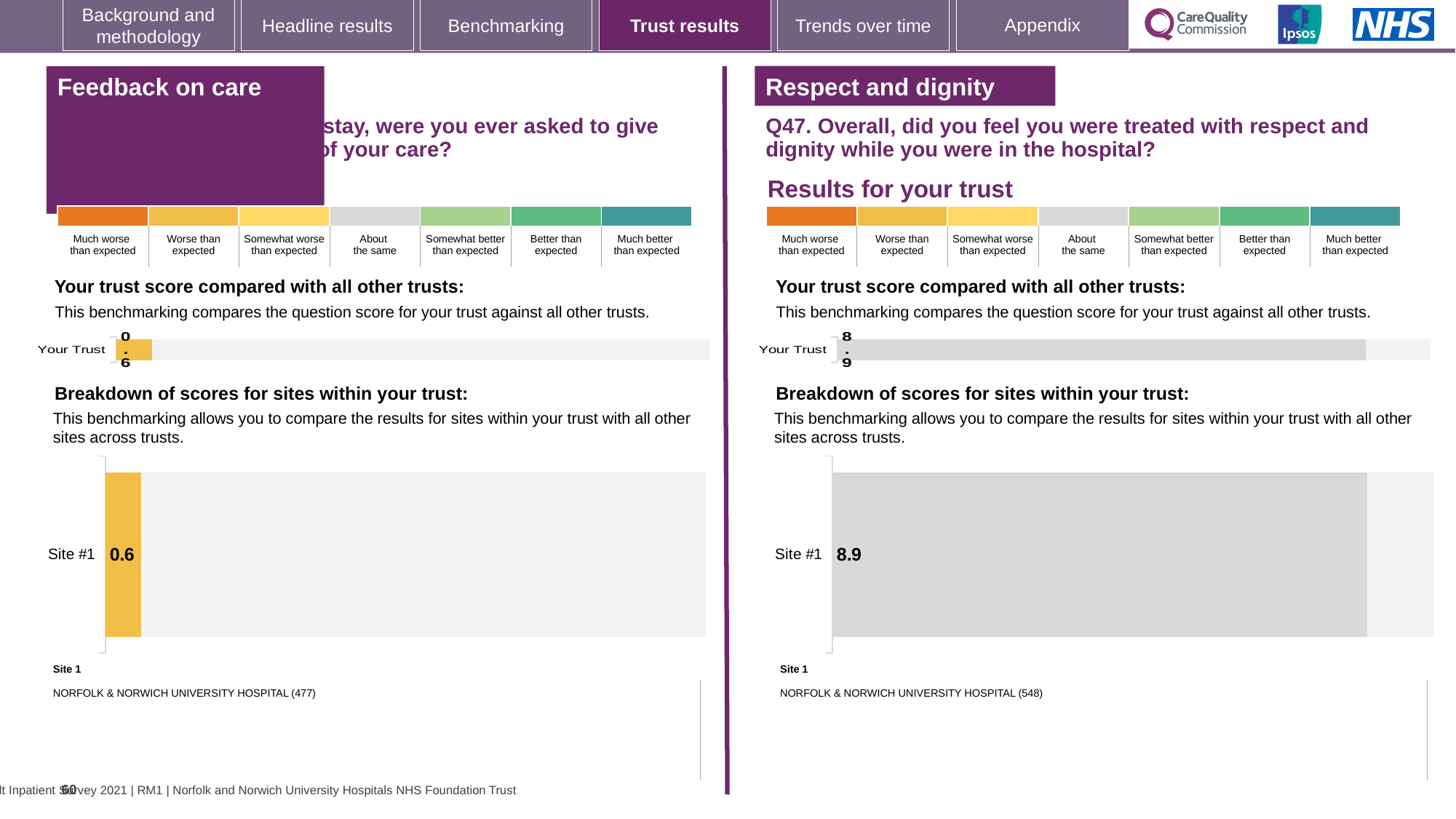
What kind of chart is used for the site breakdown in the Feedback on care section? Bar chart What colour is the Site #1 bar in the Respect and dignity site breakdown chart? Grey Which site breakdown chart shows the higher Site #1 score, Feedback on care or Respect and dignity? Respect and dignity How many sites are shown in the Respect and dignity site breakdown chart? 1 In the Feedback on care site breakdown chart, what is the score for Site #1? 0.6 In the Respect and dignity 'Your trust score compared with all other trusts' chart, what is the value for Your Trust? 8.9 What colour is the Site #1 bar in the Feedback on care site breakdown chart? Yellow In the Respect and dignity site breakdown chart, what is the score for Site #1? 8.9 In the Feedback on care 'Your trust score compared with all other trusts' chart, what is the value for Your Trust? 0.6 Is the Site #1 score in the Feedback on care breakdown chart greater or less than 5? less What is the difference between the Site #1 score in the Respect and dignity chart and the Site #1 score in the Feedback on care chart? 8.3